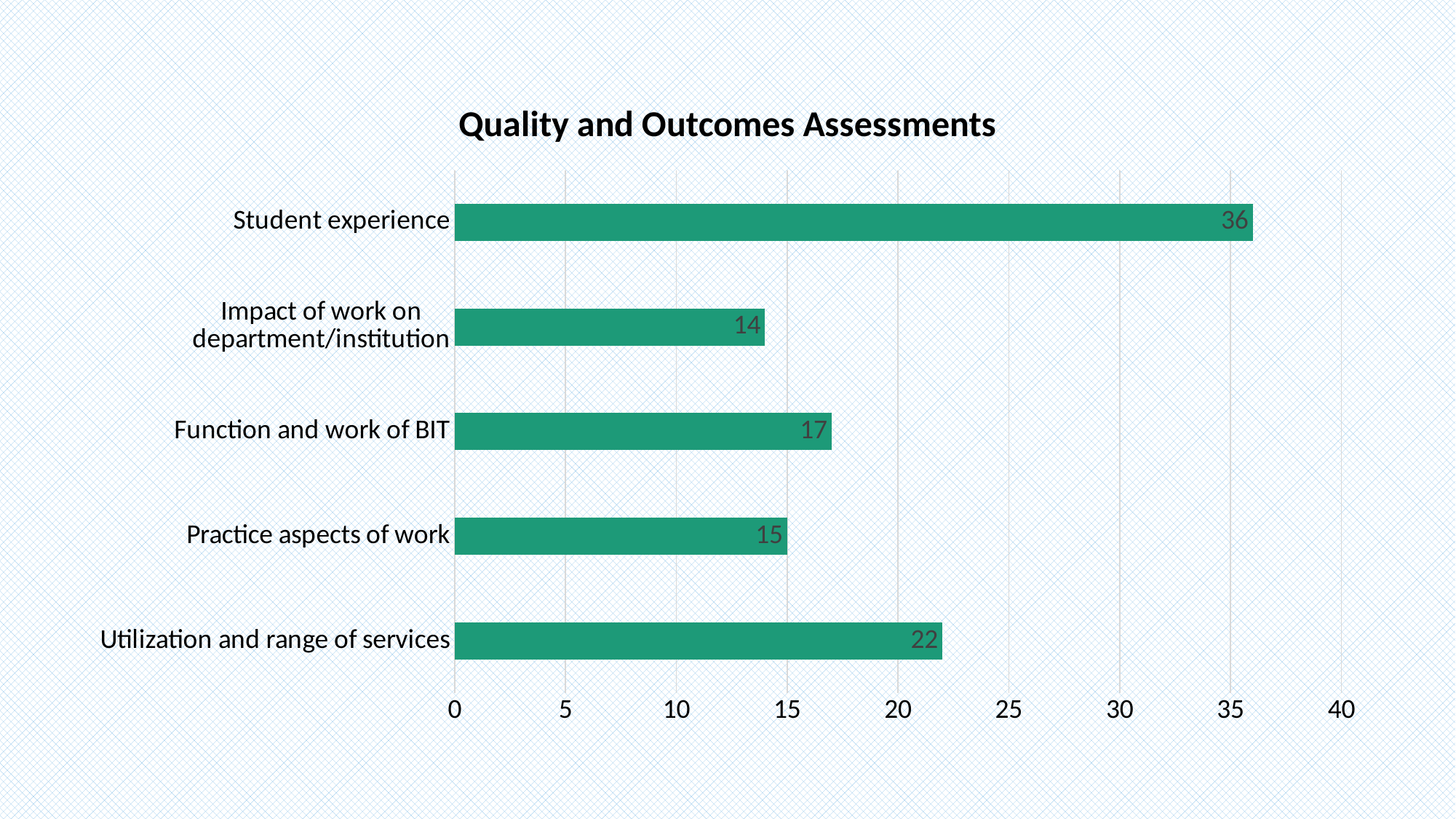
What is the value for Impact of work on department/institution? 14 Which category has the highest value? Student experience What kind of chart is shown on the slide? Bar chart What is the title of the chart? Quality and Outcomes Assessments What is the value for Student experience? 36 How many categories are shown in the chart? 5 Is the value for Utilization and range of services greater or less than 20? greater What is the difference between the values for Student experience and Utilization and range of services? 14 Which is larger, the value for Function and work of BIT or the value for Impact of work on department/institution? Function and work of BIT What is the value for Utilization and range of services? 22 What is the difference between the values for Function and work of BIT and Practice aspects of work? 2 Which category has the lowest value? Impact of work on department/institution